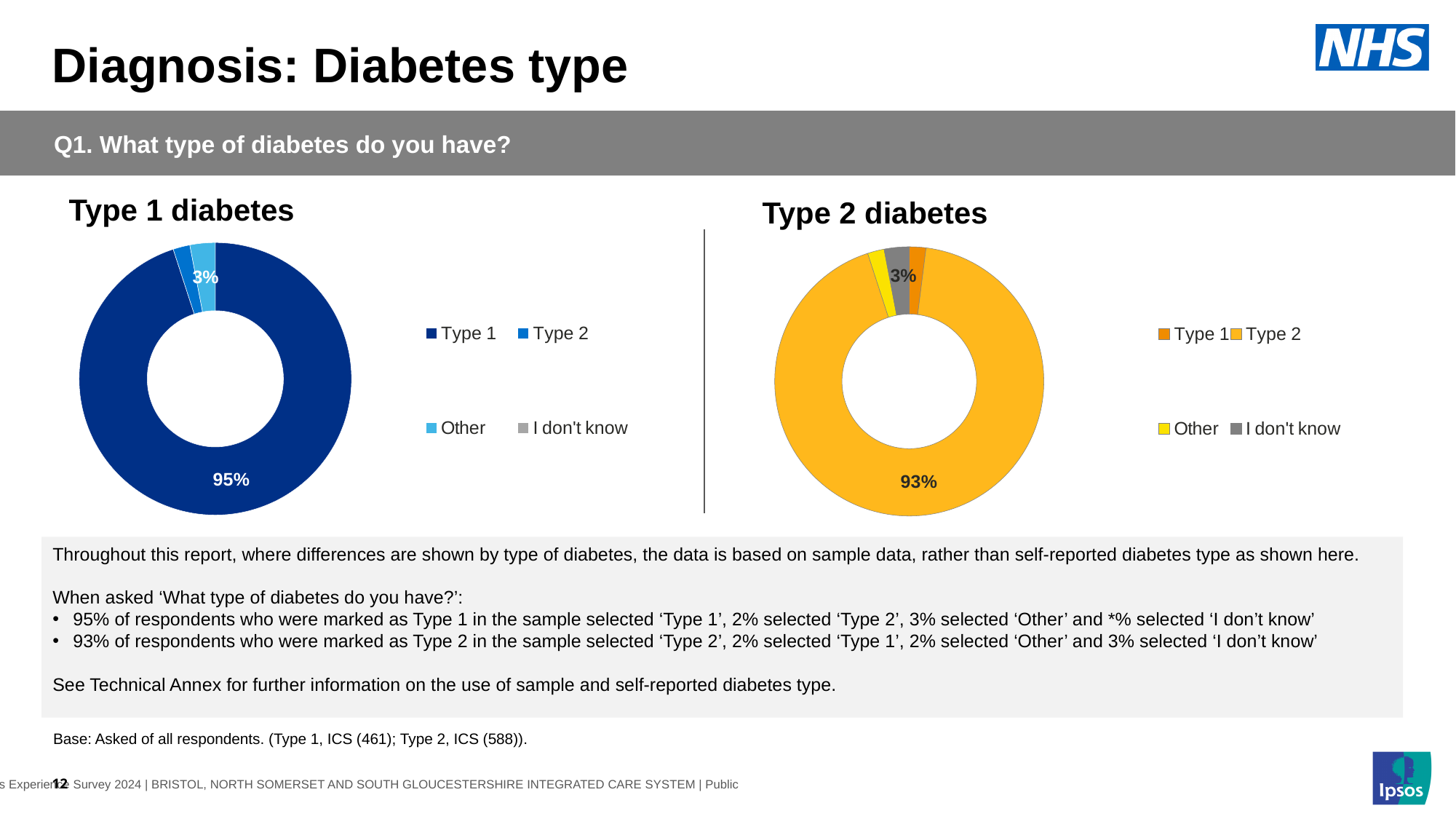
What is the difference between the 'Type 1' share in the Type 1 diabetes chart and the 'Type 2' share in the Type 2 diabetes chart? 2 percentage points What are the legend entries in the Type 1 diabetes chart? Type 1, Type 2, Other, I don't know Which is larger: the 'Type 1' share in the Type 1 diabetes chart or the 'Type 2' share in the Type 2 diabetes chart? Type 1 share in the Type 1 diabetes chart In the Type 2 diabetes chart, which category has the largest share? Type 2 In the Type 1 diabetes chart, which category has the largest share? Type 1 How many categories does the legend of the Type 2 diabetes chart list? 4 In the Type 2 diabetes chart, what percentage is shown for the 'I don't know' slice? 3% In the Type 1 diabetes chart, what percentage of respondents selected 'Type 1'? 95% What colour is the largest slice in the Type 2 diabetes chart? Orange/yellow In the Type 2 diabetes chart, what percentage of respondents selected 'Type 2'? 93% In the Type 1 diabetes chart, what percentage is shown for the 'Other' slice? 3% What kind of chart is used for the Type 1 diabetes data? Donut (pie) chart